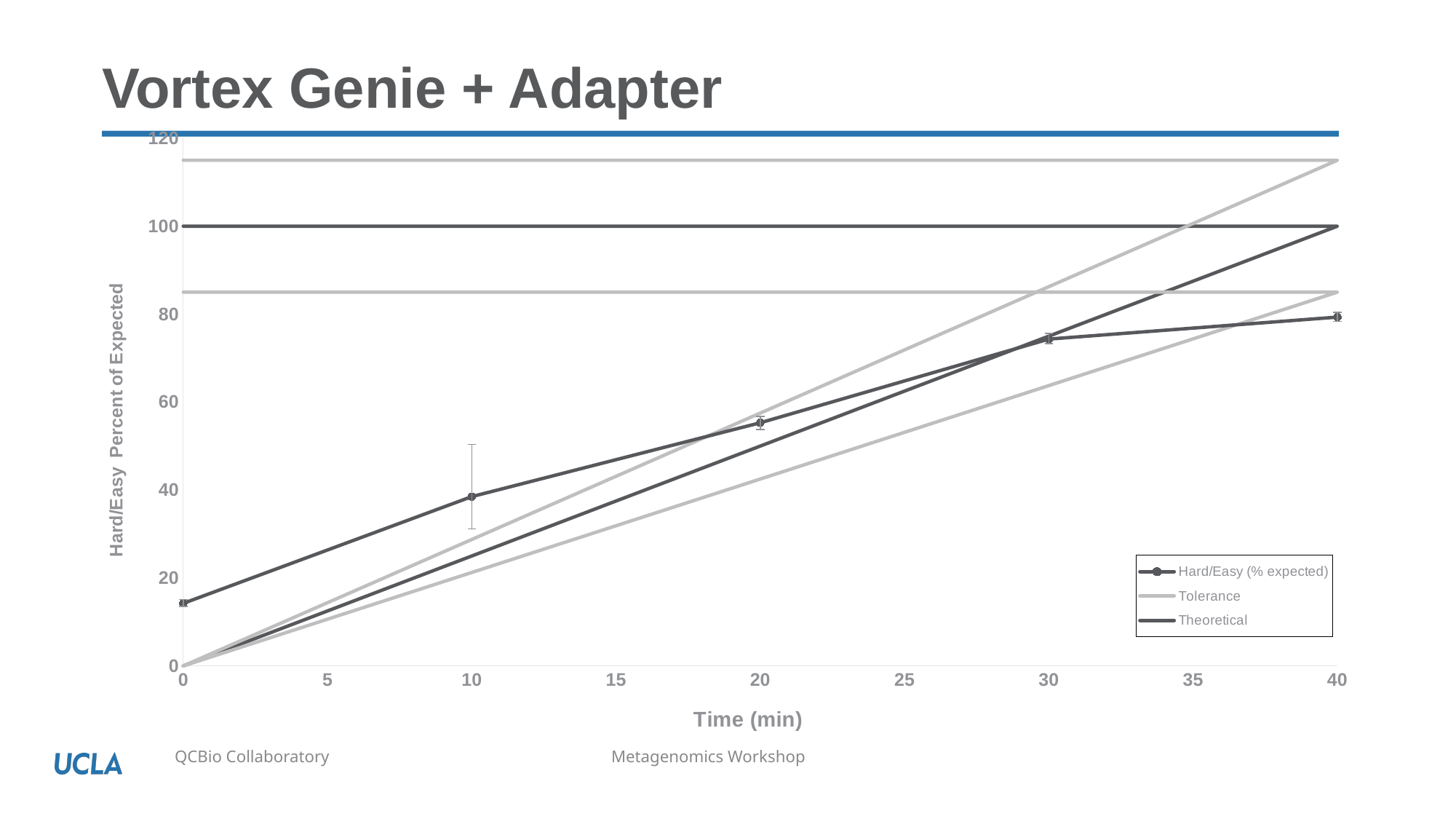
What is the label of the x axis? Time (min) How many series does the legend list? 3 At 40 min, which is larger: the Hard/Easy (% expected) value or the Theoretical value? Theoretical Does the Hard/Easy (% expected) series rise or fall as time increases from 0 to 40 min? rise Is the Hard/Easy (% expected) value at 0 min greater or less than 20? less Is the Hard/Easy (% expected) value at 20 min greater or less than 60? less How many data points are plotted for the Hard/Easy (% expected) series? 5 At which time is the Hard/Easy (% expected) value highest? 40 At which time is the Hard/Easy (% expected) value lowest? 0 What kind of chart is shown on the slide? line chart Is the Hard/Easy (% expected) value at 10 min greater or less than 40? less